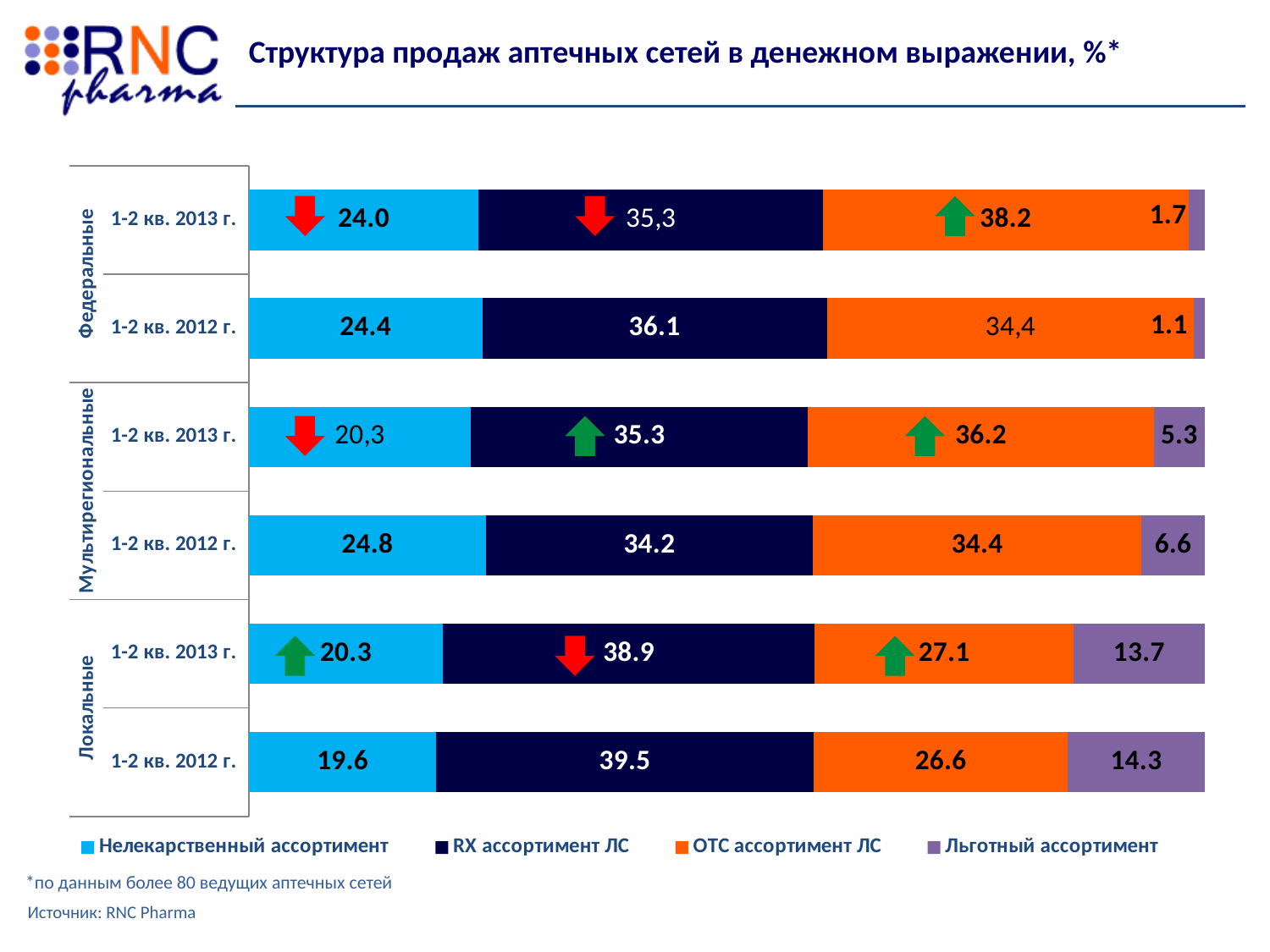
How many series does the legend list? 4 How many bars are plotted in the chart? 6 Which bar has the lowest value for Льготный ассортимент? Федеральные, 1-2 кв. 2012 г. What kind of chart is shown on the slide? Stacked bar chart What is the value of Нелекарственный ассортимент for Федеральные in 1-2 кв. 2013 г.? 24.0 What is the value of Льготный ассортимент for Локальные in 1-2 кв. 2012 г.? 14.3 Which series is shown in orange in the legend? OTC ассортимент ЛС Which is larger: OTC ассортимент ЛС for Федеральные in 1-2 кв. 2013 г. or in 1-2 кв. 2012 г.? 1-2 кв. 2013 г. What is the value of OTC ассортимент ЛС for Мультирегиональные in 1-2 кв. 2013 г.? 36.2 What is the difference between the RX ассортимент ЛС values for Локальные in 1-2 кв. 2012 г. and 1-2 кв. 2013 г.? 0.6 Which bar has the highest value for Льготный ассортимент? Локальные, 1-2 кв. 2012 г. What is the value of RX ассортимент ЛС for Федеральные in 1-2 кв. 2012 г.? 36.1